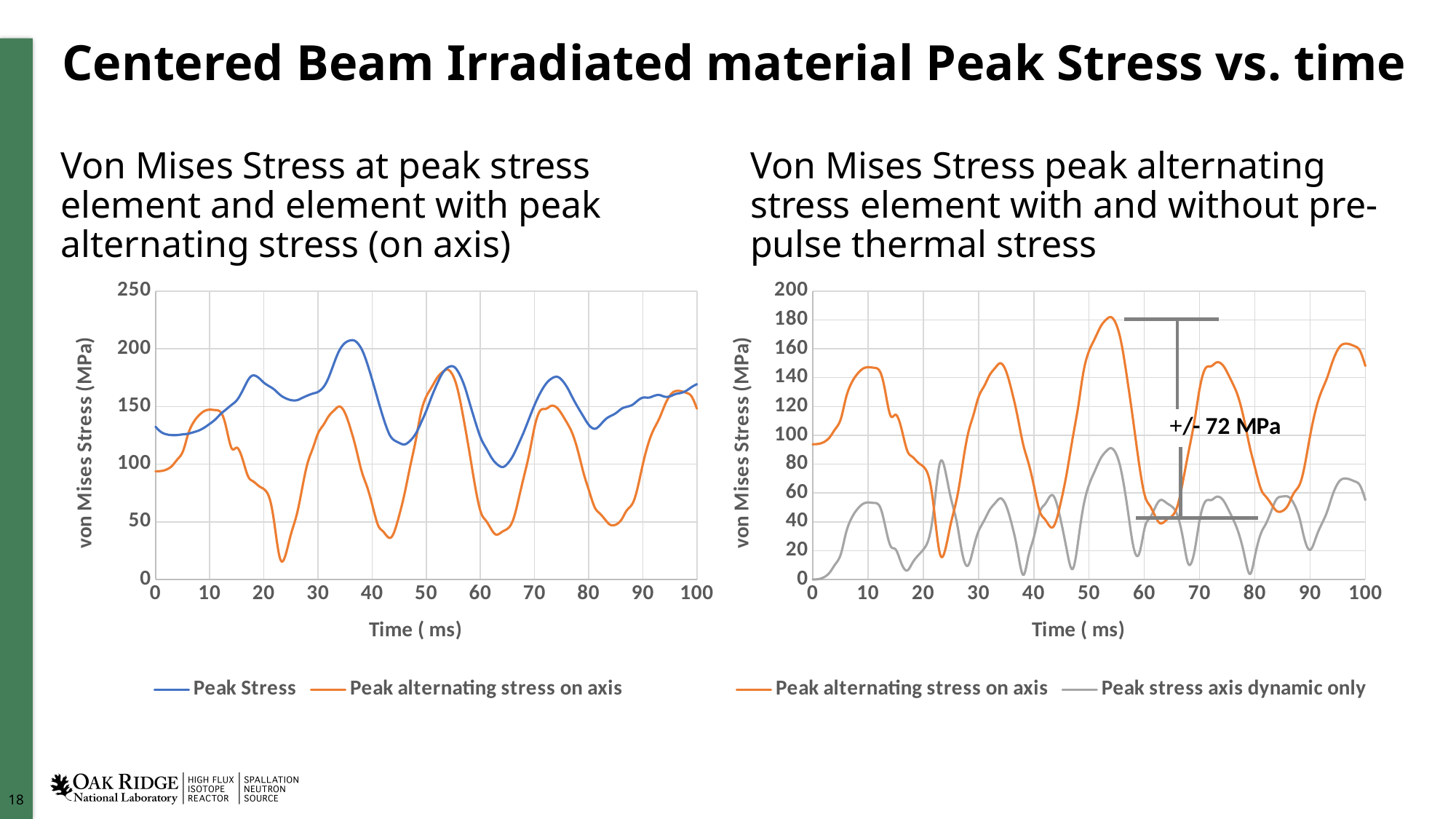
How many series does the legend of the left chart list? 2 In the right chart, at about 54 ms, which series has the larger value: Peak alternating stress on axis or Peak stress axis dynamic only? Peak alternating stress on axis In the left chart, is the value of Peak alternating stress on axis at about 23 ms greater or less than 50? less In the right chart, is the value of Peak alternating stress on axis at about 54 ms greater or less than 160? greater In the left chart, is the value of Peak Stress at 36 ms greater or less than 150? greater How many series does the legend of the right chart list? 2 What is the y-axis label of the left chart? von Mises Stress (MPa) In the left chart, at about 36 ms, which series has the larger value: Peak Stress or Peak alternating stress on axis? Peak Stress What amplitude is annotated on the right chart? +/- 72 MPa In the right chart, which series reaches the highest value overall? Peak alternating stress on axis What kind of chart is the left chart on the slide? line chart